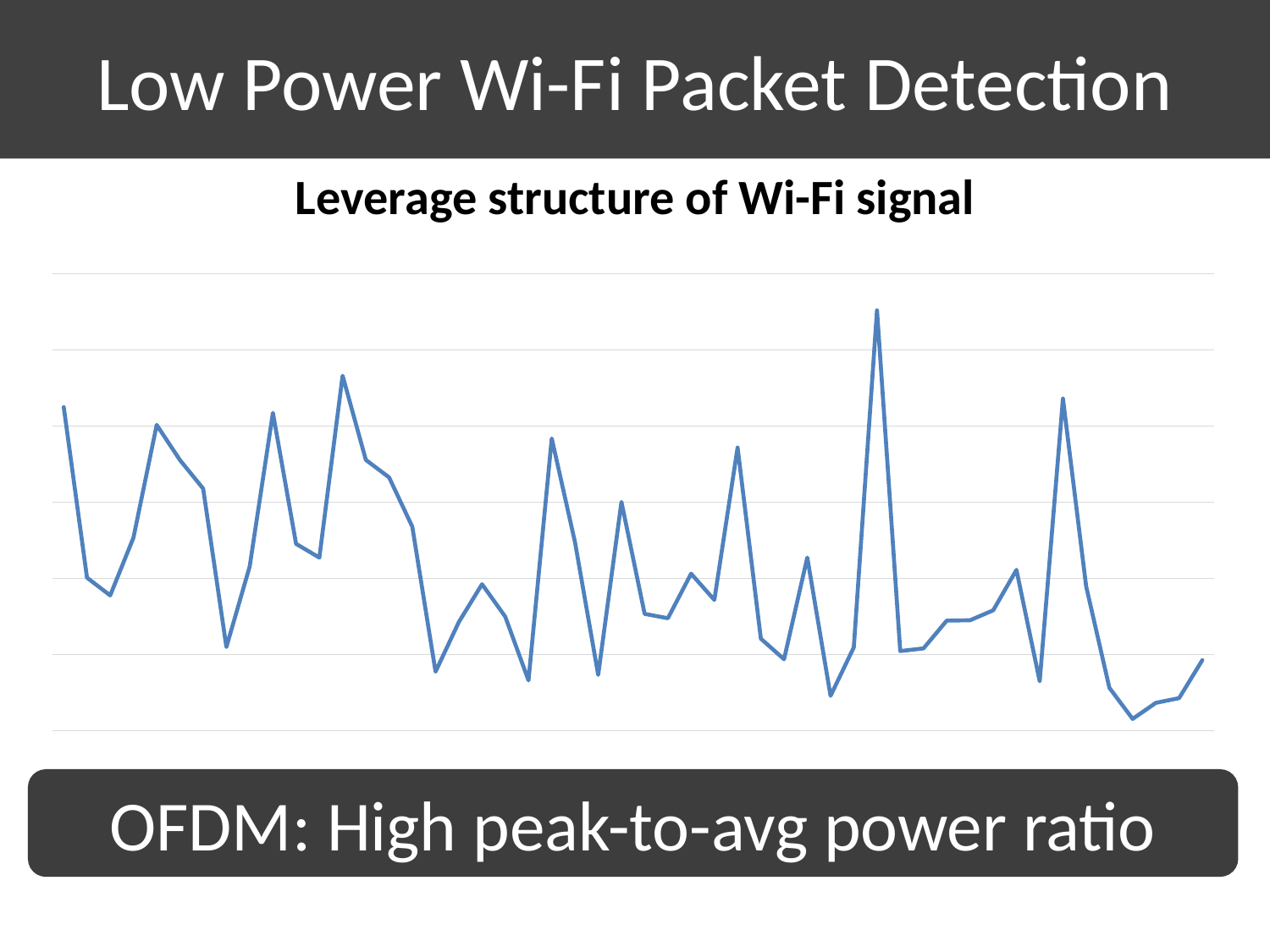
How many data series (lines) are plotted on the chart? 1 What colour is the line in the chart? blue Is the tallest spike of the line in the left half or the right half of the chart? right half Does the chart display a legend? No What kind of chart is shown on the slide? line chart Is the lowest point of the line in the left half or the right half of the chart? right half